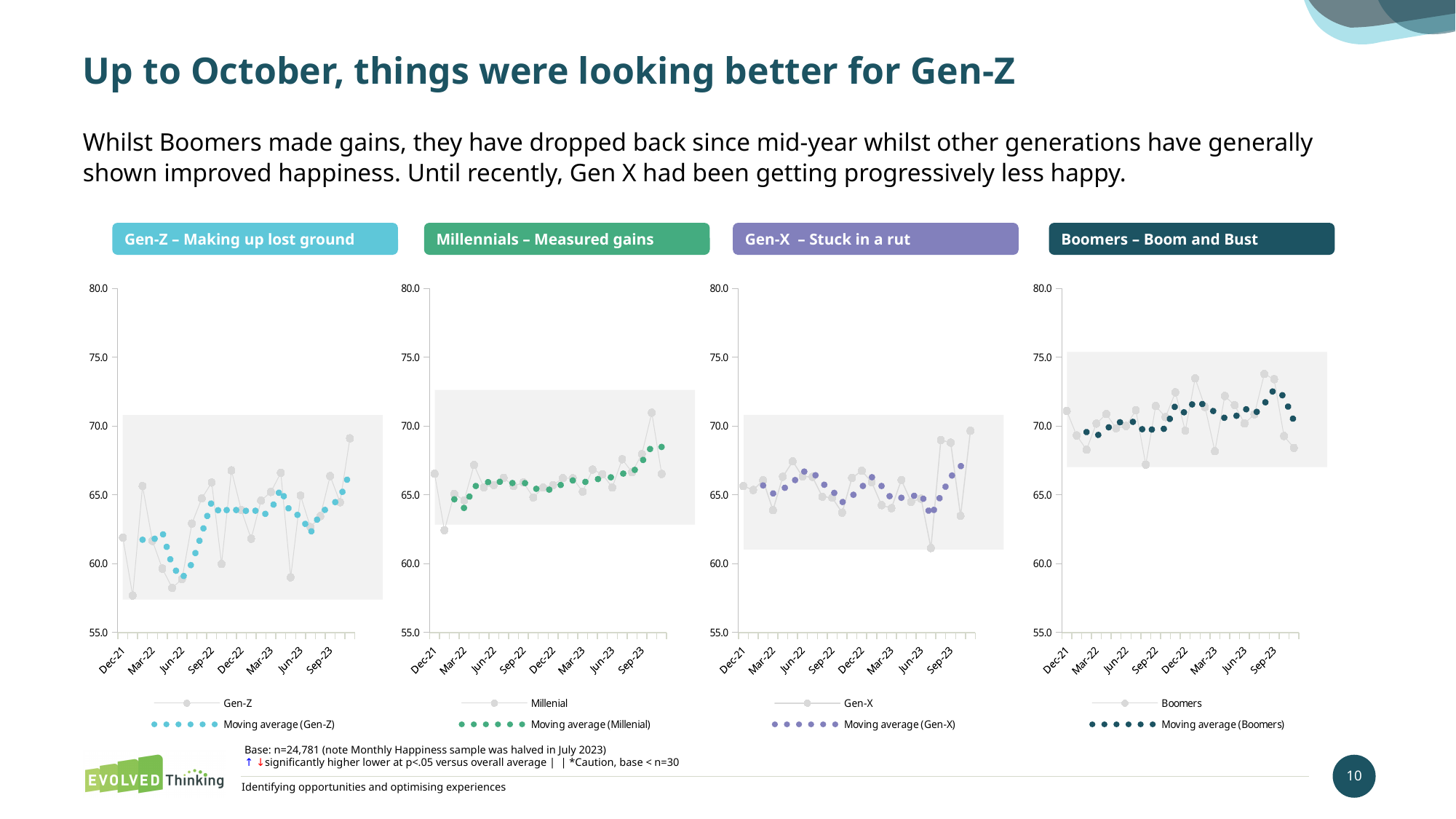
What is the highest value shown on the y axis of the "Gen-X – Stuck in a rut" chart? 80.0 In the "Millennials – Measured gains" chart, is the Millenial value for Dec-21 greater or less than 65? greater In the "Boomers – Boom and Bust" chart, is the Moving average (Boomers) value for Sep-23 greater or less than 70? greater In the "Millennials – Measured gains" chart, does the Moving average (Millenial) series generally rise or fall from Dec-21 to Sep-23? Rise What kind of chart is the "Gen-Z – Making up lost ground" chart? Line chart How many charts are shown on the slide? 4 In the "Gen-X – Stuck in a rut" chart, is the lowest Gen-X value greater or less than 65? less How many series does the legend of the "Boomers – Boom and Bust" chart list? 2 In the "Millennials – Measured gains" chart, what are the two legend entries? Millenial; Moving average (Millenial)